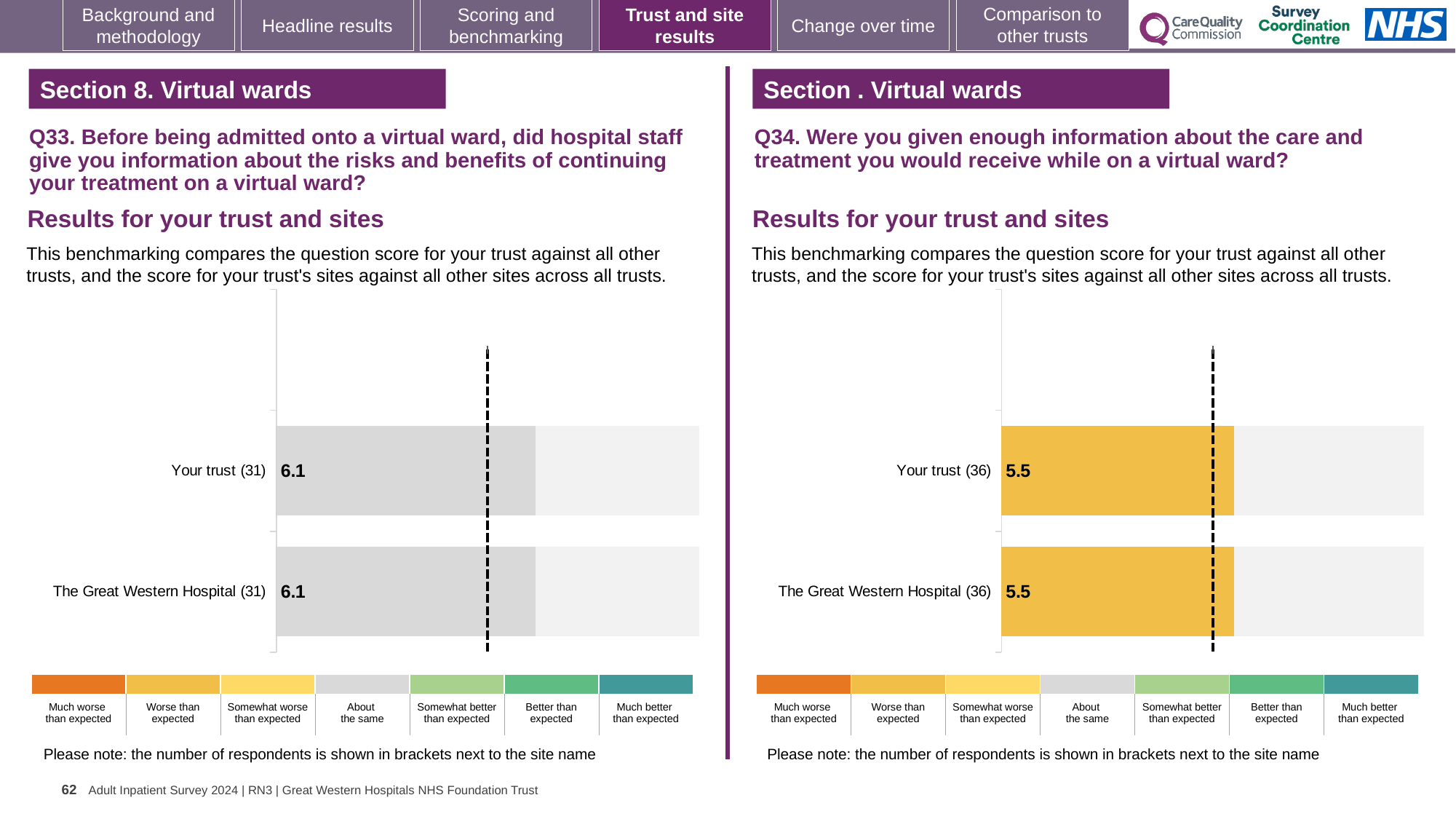
On the Q33 chart on the left, how many respondents are shown in brackets next to Your trust? 31 On the Q33 chart on the left, what is the score for Your trust? 6.1 What kind of chart is used for the Q33 results on the left? Bar chart On the Q33 chart on the left, what is the score for The Great Western Hospital? 6.1 How many bars are plotted on the Q34 chart on the right? 2 On the Q34 chart on the right, how many respondents are shown in brackets next to The Great Western Hospital? 36 On the Q34 chart on the right, what is the score for Your trust? 5.5 How many bars are plotted on the Q33 chart on the left? 2 On the Q33 chart on the left, what is the difference between the score for Your trust and the score for The Great Western Hospital? 0 On the Q34 chart on the right, what is the score for The Great Western Hospital? 5.5 On the Q34 chart on the right, what is the difference between the score for Your trust and the score for The Great Western Hospital? 0 On the Q34 chart on the right, which benchmark category does the colour of the bars correspond to according to the legend? Worse than expected